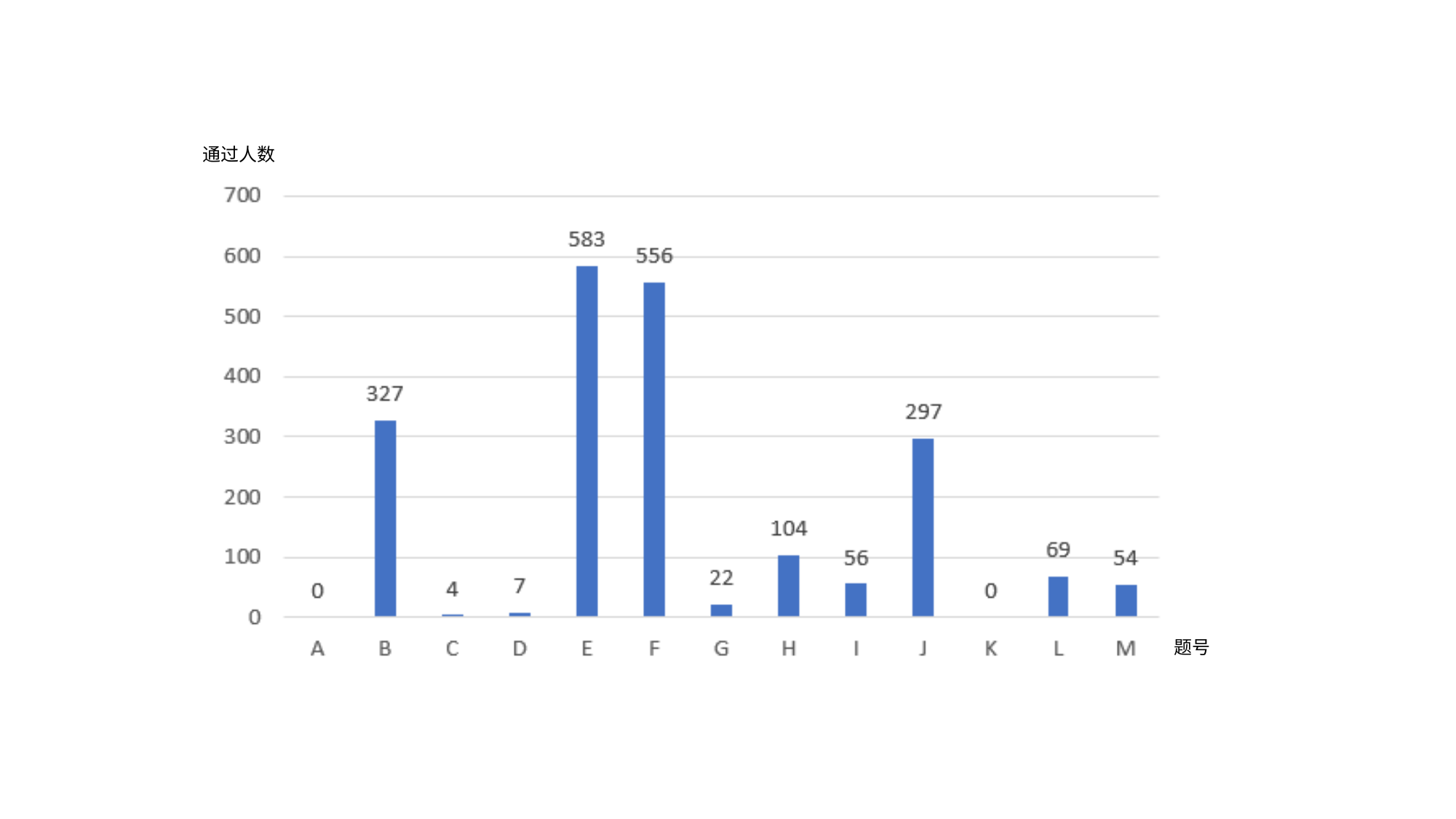
What is the value for E? 583 Is the value for B greater or less than 300? greater How many categories are shown on the x axis? 13 What is the label on the y axis? 通过人数 What is the value for J? 297 What kind of chart is this? bar chart What is the difference between the values for B and J? 30 Which category has the highest value? E What is the value for H? 104 Which categories have a value of 0? A and K Which is larger, the value for L or the value for M? L What is the difference between the values for E and F? 27